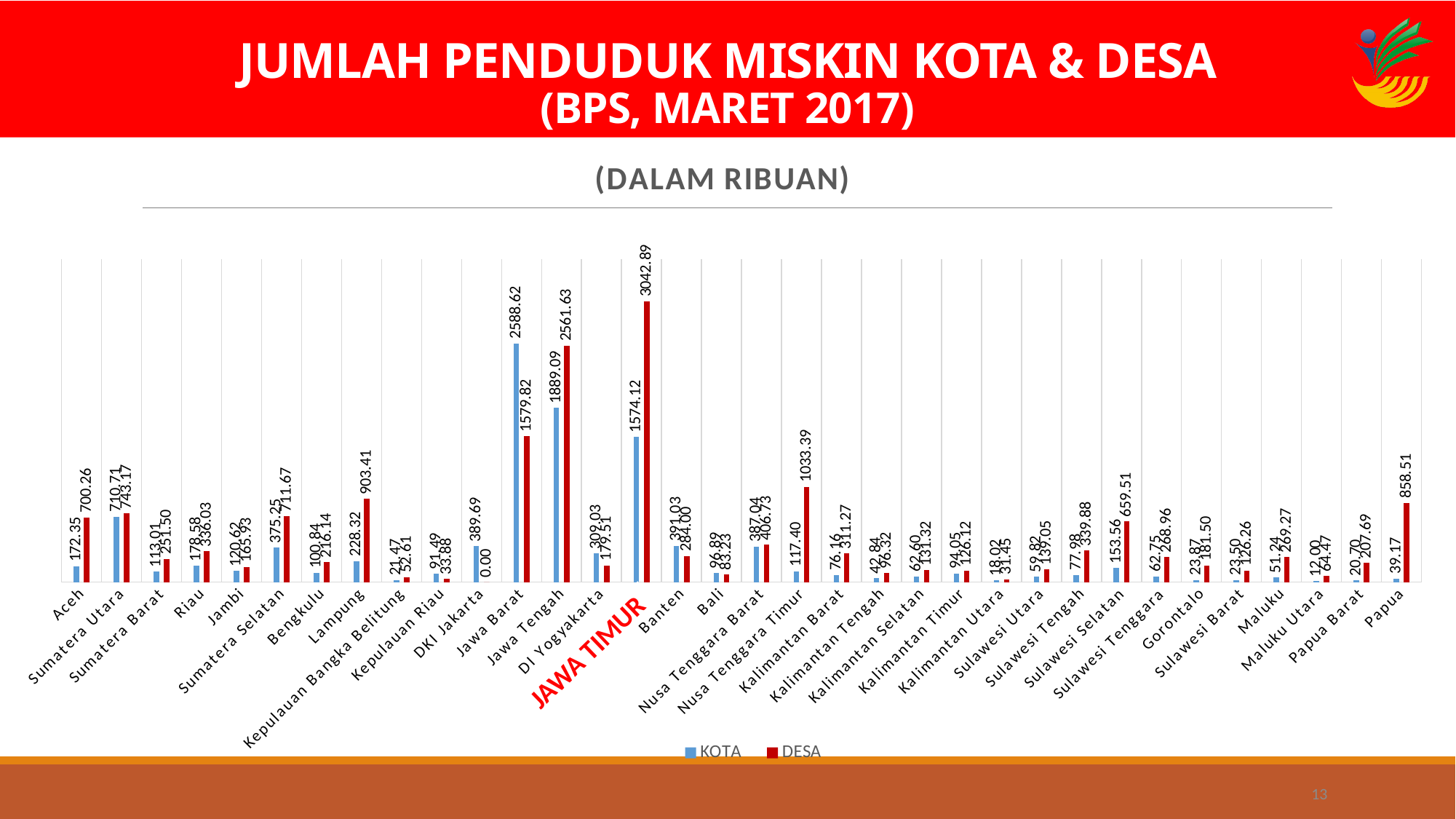
Which is larger, the KOTA value for Jawa Tengah or the KOTA value for Jawa Timur? Jawa Tengah How many series does the legend list? 2 Which province has the highest DESA value? Jawa Timur What type of chart is shown on the slide? bar chart What are the two series named in the legend? KOTA and DESA Which is larger, the DESA value for Lampung or the DESA value for Papua? Lampung What is the KOTA value for Jawa Barat? 2588.62 What is the difference between the DESA and KOTA values for Jawa Timur? 1468.77 What is the DESA value for DKI Jakarta? 0.00 What is the DESA value for Papua? 858.51 Which province has the highest KOTA value? Jawa Barat What is the DESA value for Jawa Timur? 3042.89